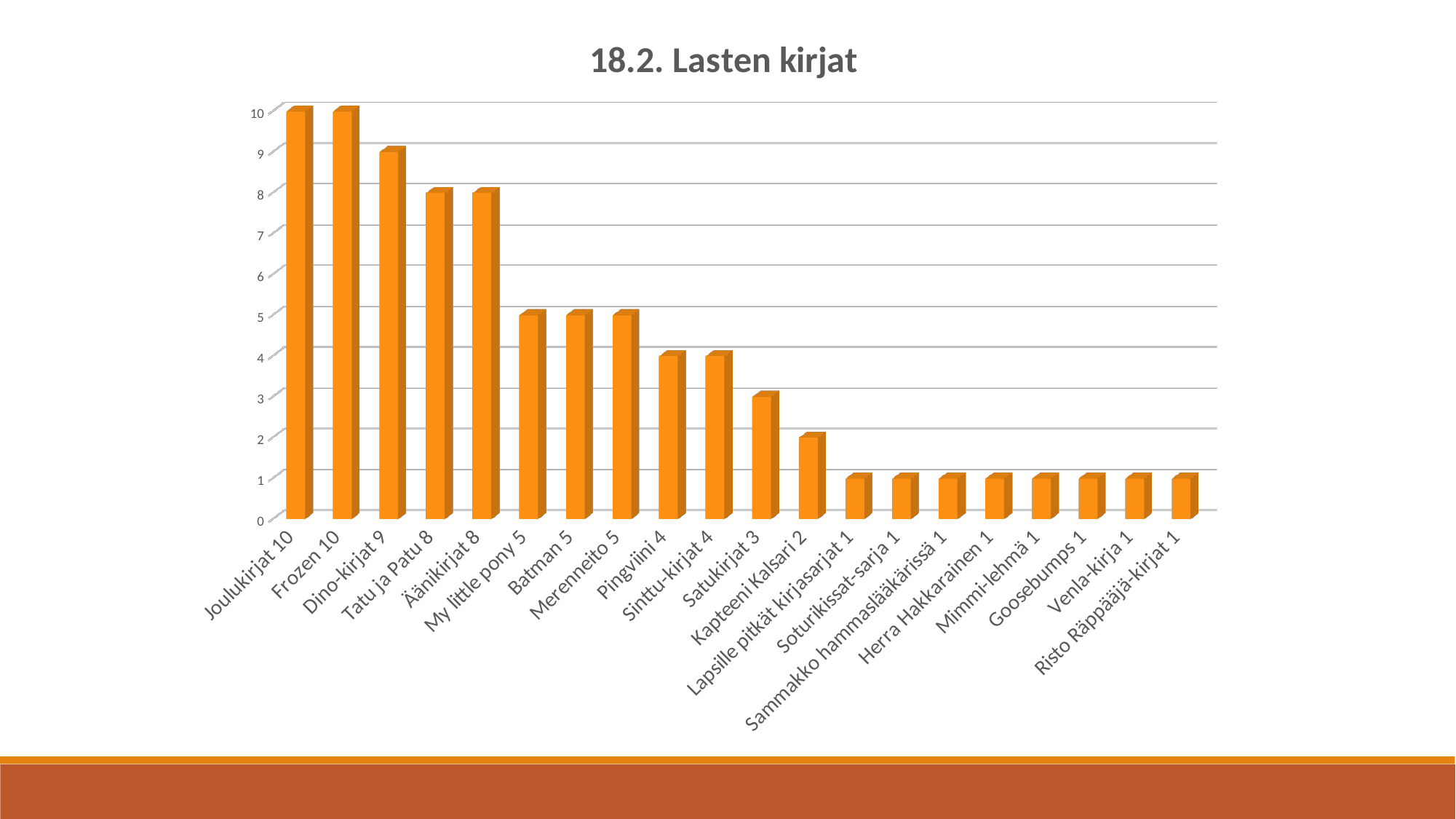
How many categories are shown in the chart? 20 Is the value for Merenneito greater or less than 4? greater What is the value for Kapteeni Kalsari? 2 What is the value for Satukirjat? 3 What is the difference between the values for Tatu ja Patu and Satukirjat? 5 What is the lowest value shown in the chart? 1 Do the values rise or fall from left to right along the x axis? fall What is the difference between the values for Frozen and Pingviini? 6 What is the value for Dino-kirjat? 9 Which has a larger value, Batman or Pingviini? Batman What kind of chart is shown on the slide? bar chart What is the highest value shown in the chart? 10